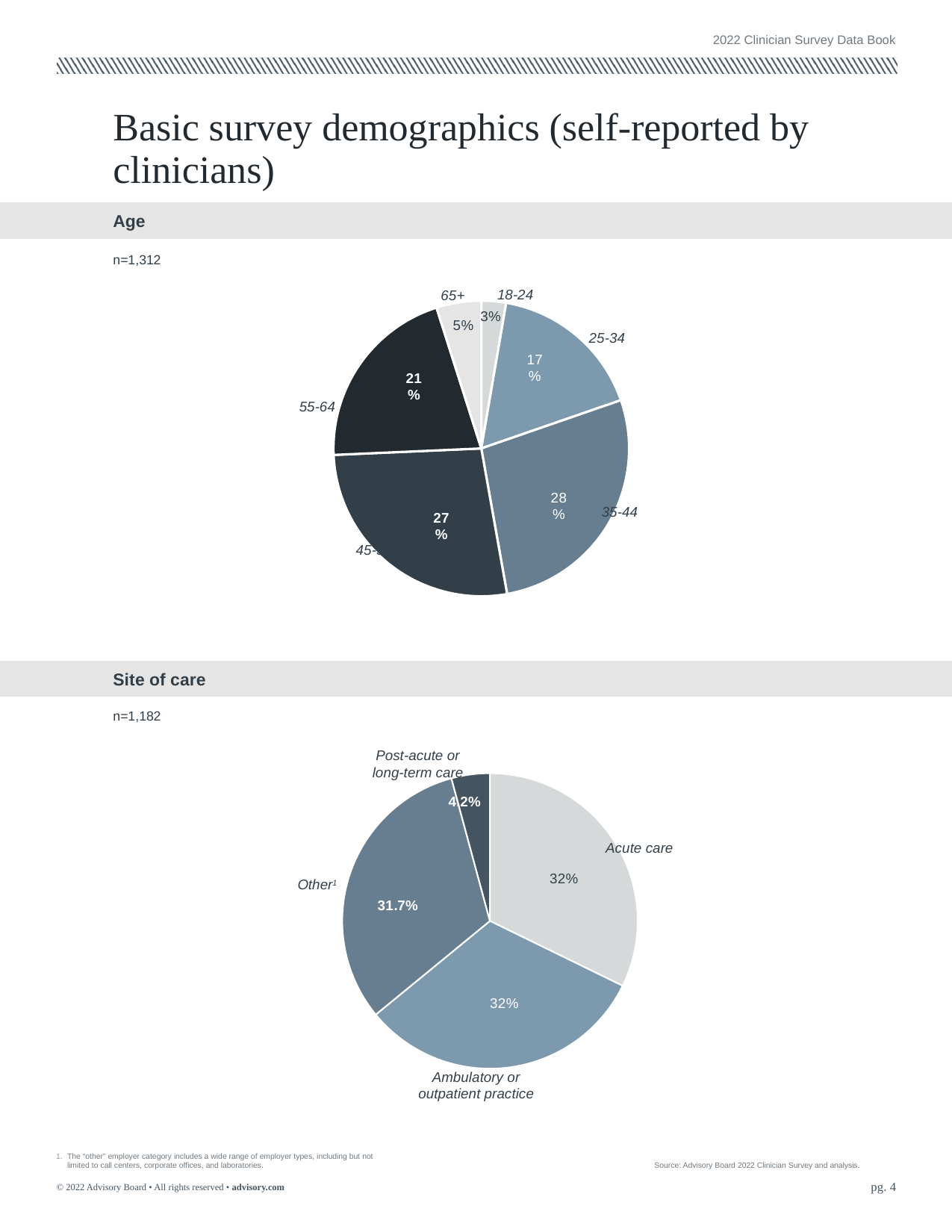
In the Age pie chart, what is the value for the 65+ group? 5% In the Site of care pie chart, which site of care has the smallest share? Post-acute or long-term care In the Age pie chart, what percentage of clinicians are aged 25-34? 17% What type of chart is used for the Site of care data? Pie chart In the Site of care pie chart, what share of respondents work in acute care? 32% In the Age pie chart, how many age groups are shown? 6 In the Site of care pie chart, what is the value for Other? 31.7% In the Age pie chart, what is the difference between the 55-64 share and the 65+ share? 16% In the Age pie chart, what share of respondents are aged 35-44? 28% In the Site of care pie chart, is the share for Acute care larger or smaller than the share for Post-acute or long-term care? larger In the Age pie chart, which age group has the smallest share? 18-24 In the Age pie chart, which age group has the largest share? 35-44